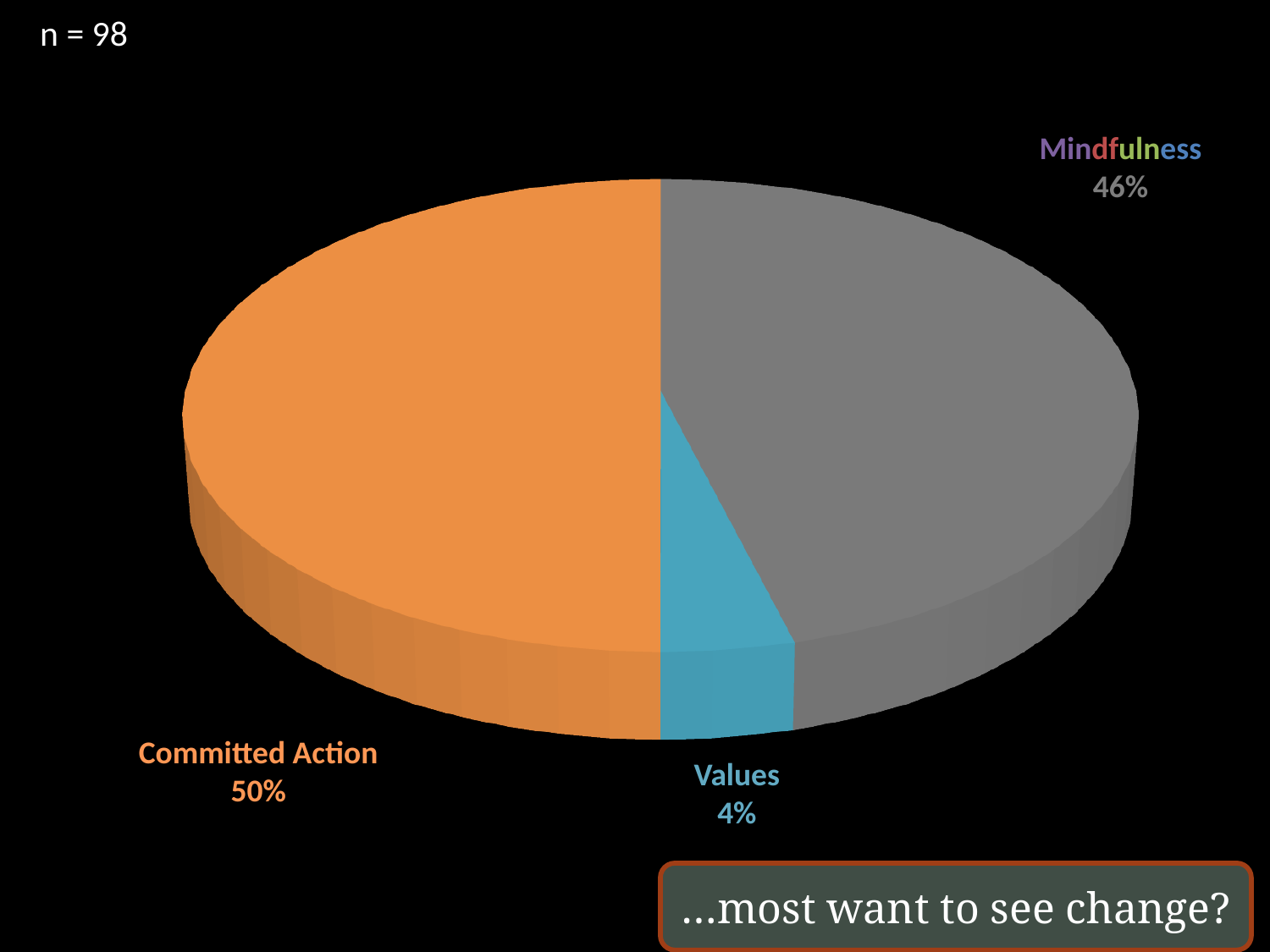
Which category has the smallest share of the pie? Values What is the difference in percentage points between Mindfulness and Values? 42 What percentage of the pie is Mindfulness? 46% Which category has the largest share of the pie? Committed Action How many categories are shown in the pie chart? 3 Which is larger, the share for Mindfulness or the share for Values? Mindfulness What kind of chart is shown on the slide? Pie chart What percentage of the pie is Values? 4% What colour is the Values slice of the pie? Blue What is the sample size (n) stated on the slide? 98 What percentage of the pie is Committed Action? 50% What is the difference in percentage points between Committed Action and Mindfulness? 4